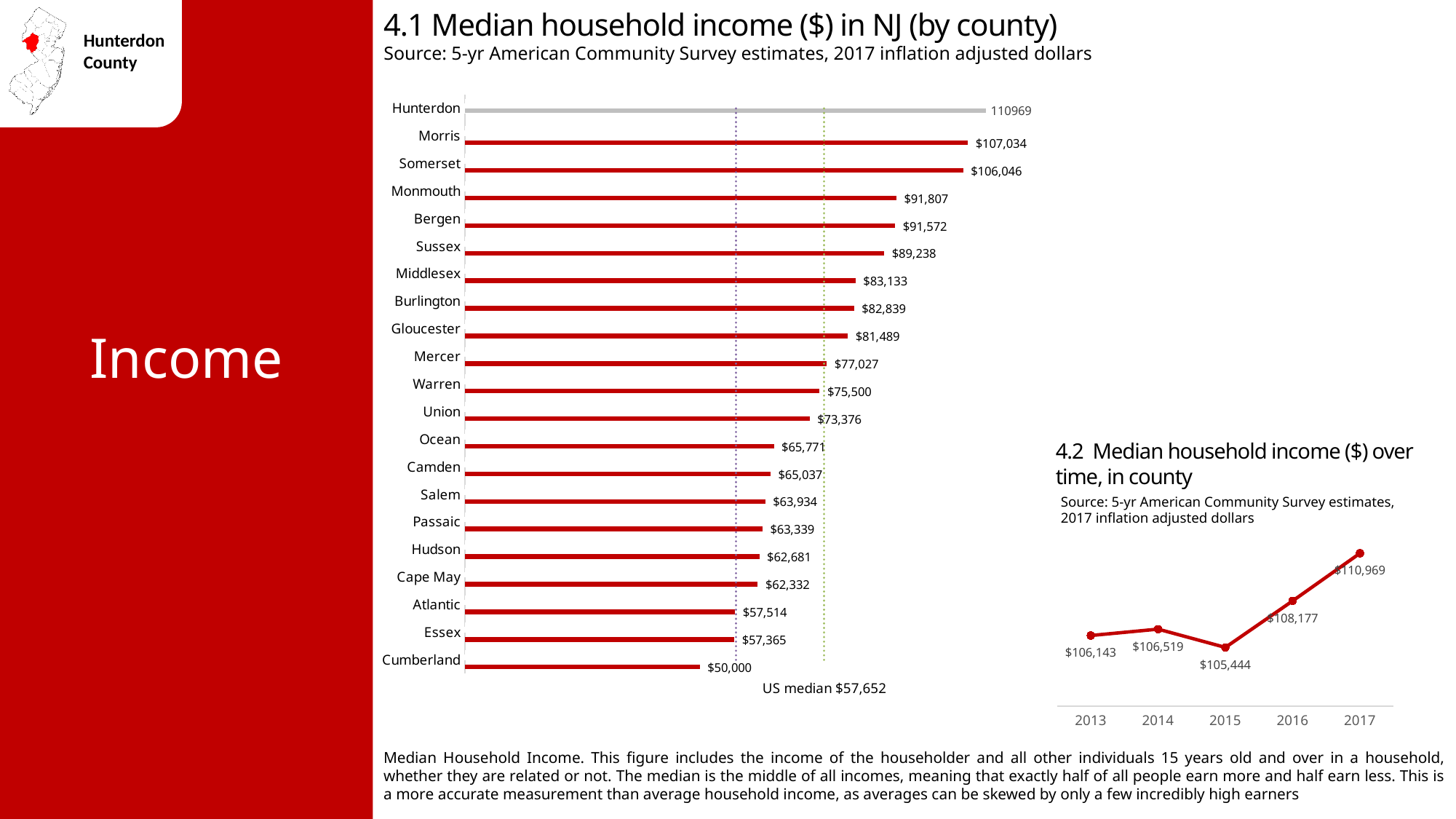
What kind of chart is chart 4.2 Median household income ($) over time, in county? Line chart In chart 4.1 Median household income ($) in NJ (by county), which county has the lowest median household income? Cumberland What kind of chart is chart 4.1 Median household income ($) in NJ (by county)? Bar chart In chart 4.1 Median household income ($) in NJ (by county), what is the difference between the values for Morris and Somerset? $988 In chart 4.1 Median household income ($) in NJ (by county), what is the median household income for Cumberland? $50,000 In chart 4.2 Median household income ($) over time, in county, what is the value for 2015? $105,444 In chart 4.1 Median household income ($) in NJ (by county), which has a higher median household income, Sussex or Middlesex? Sussex In chart 4.2 Median household income ($) over time, in county, what is the difference between the 2017 and 2013 values? $4,826 In chart 4.2 Median household income ($) over time, in county, which year has the highest value? 2017 In chart 4.1 Median household income ($) in NJ (by county), how many counties are shown? 21 In chart 4.1 Median household income ($) in NJ (by county), which county has the highest median household income? Hunterdon In chart 4.1 Median household income ($) in NJ (by county), what is the median household income for Morris? $107,034